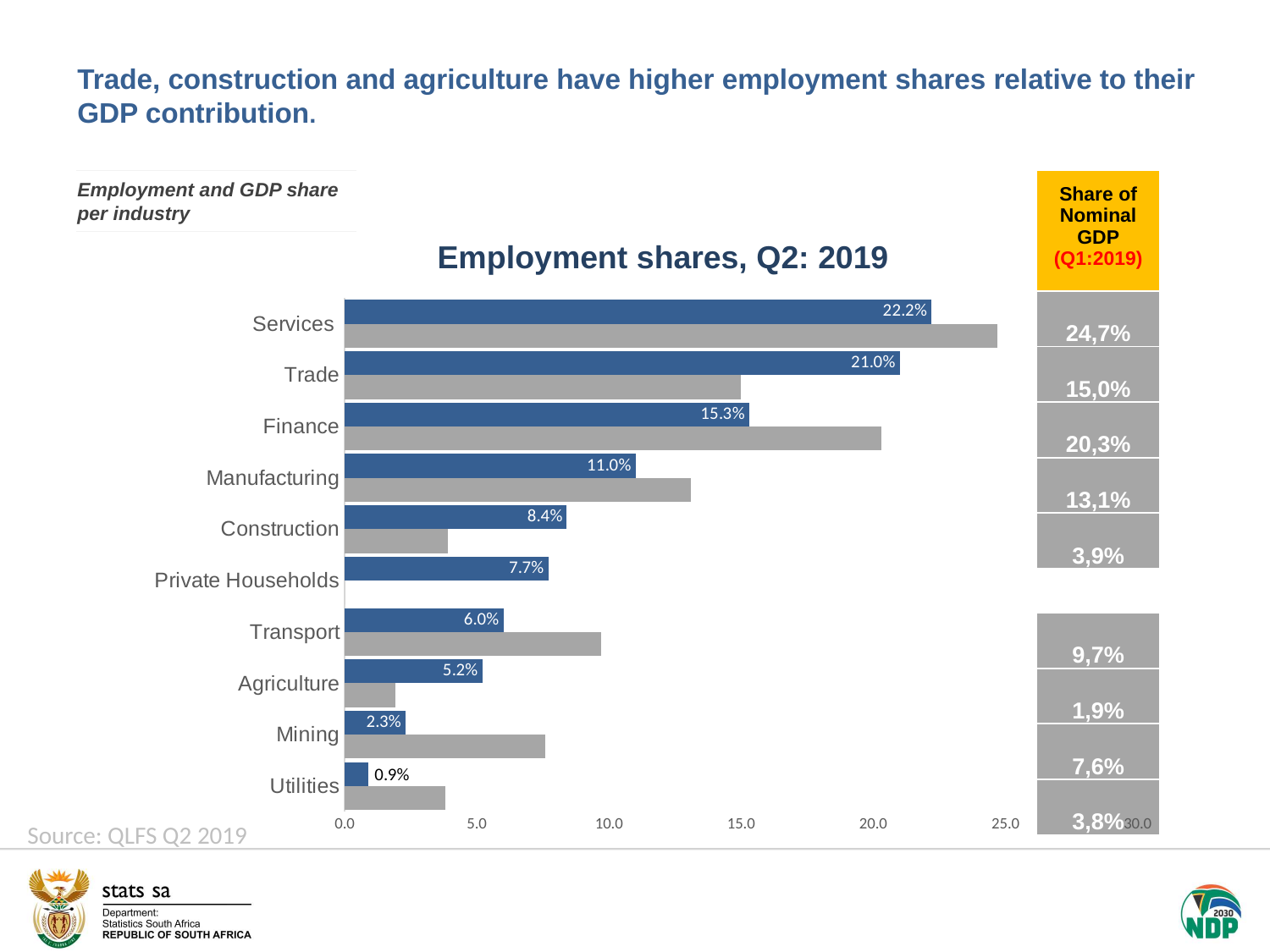
Is the value of the grey bar for Construction greater or less than 5.0? less How many industries are shown on the chart? 10 What type of chart is shown on the slide? Bar chart What is the difference between the employment shares of Agriculture and Mining? 2.9% What is the employment share for Services? 22.2% Which industry has the highest employment share? Services What is the employment share for Construction? 8.4% Which industry has the lowest employment share? Utilities What is the employment share for Utilities? 0.9% Is the value of the grey bar for Services greater or less than 20.0? greater Which has a larger employment share, Manufacturing or Transport? Manufacturing What is the difference between the employment shares of Trade and Finance? 5.7%